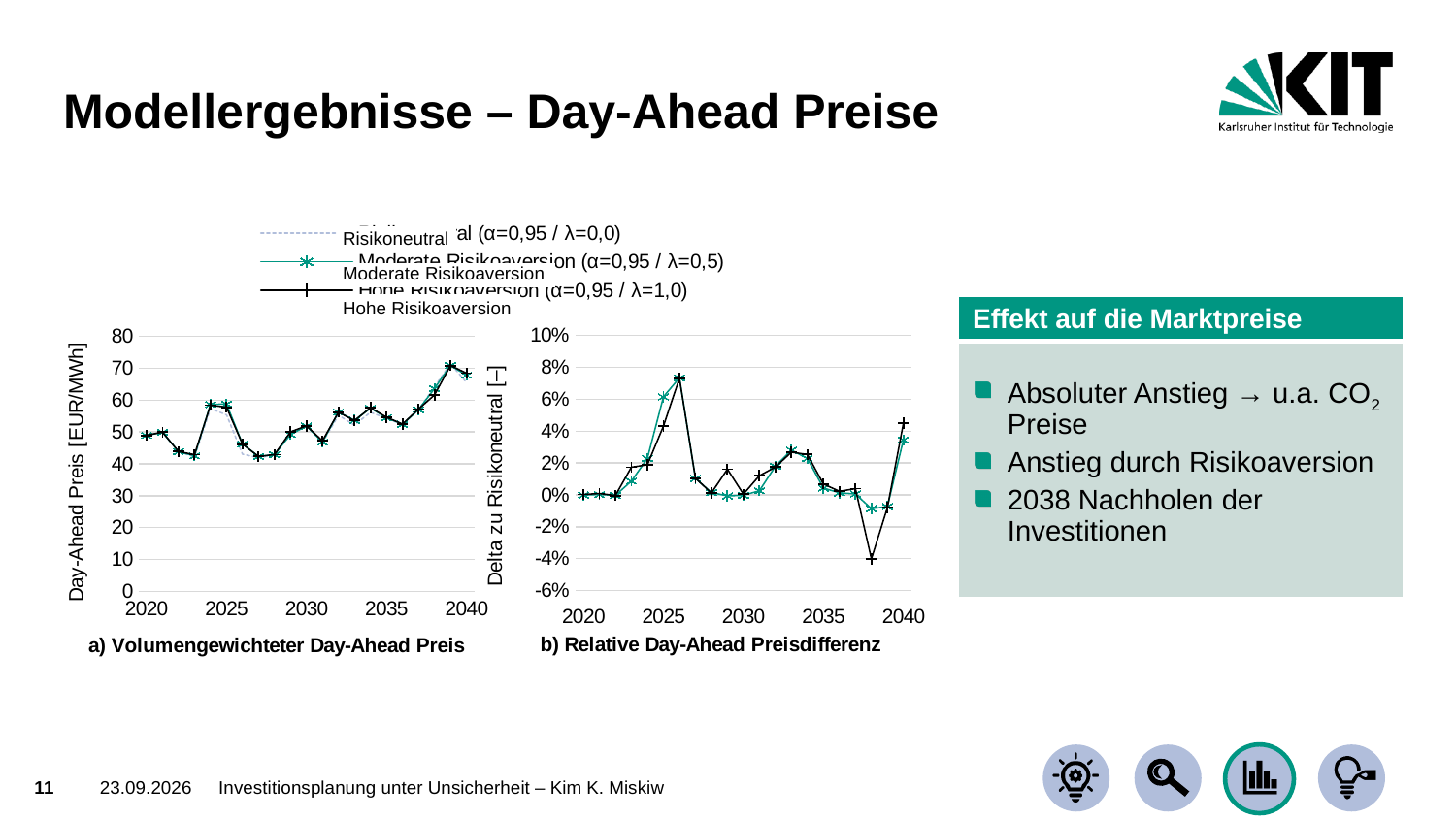
What is the y-axis label of chart a) "Volumengewichteter Day-Ahead Preis"? Day-Ahead Preis [EUR/MWh] What kind of chart is chart a) "Volumengewichteter Day-Ahead Preis"? line chart In chart a) "Volumengewichteter Day-Ahead Preis", is the value for 2027 greater or less than 50? less In chart a) "Volumengewichteter Day-Ahead Preis", is the value for 2040 greater or less than 60? greater In chart b) "Relative Day-Ahead Preisdifferenz", in which year does the series reach its highest value? 2026 In chart b) "Relative Day-Ahead Preisdifferenz", is the value for 2026 greater or less than 4%? greater In chart b) "Relative Day-Ahead Preisdifferenz", in which year does Hohe Risikoaversion reach its lowest value? 2038 How many series does the legend list for the charts? 3 In chart a) "Volumengewichteter Day-Ahead Preis", do the values overall rise or fall from 2020 to 2040? rise What is the y-axis label of chart b) "Relative Day-Ahead Preisdifferenz"? Delta zu Risikoneutral [–]